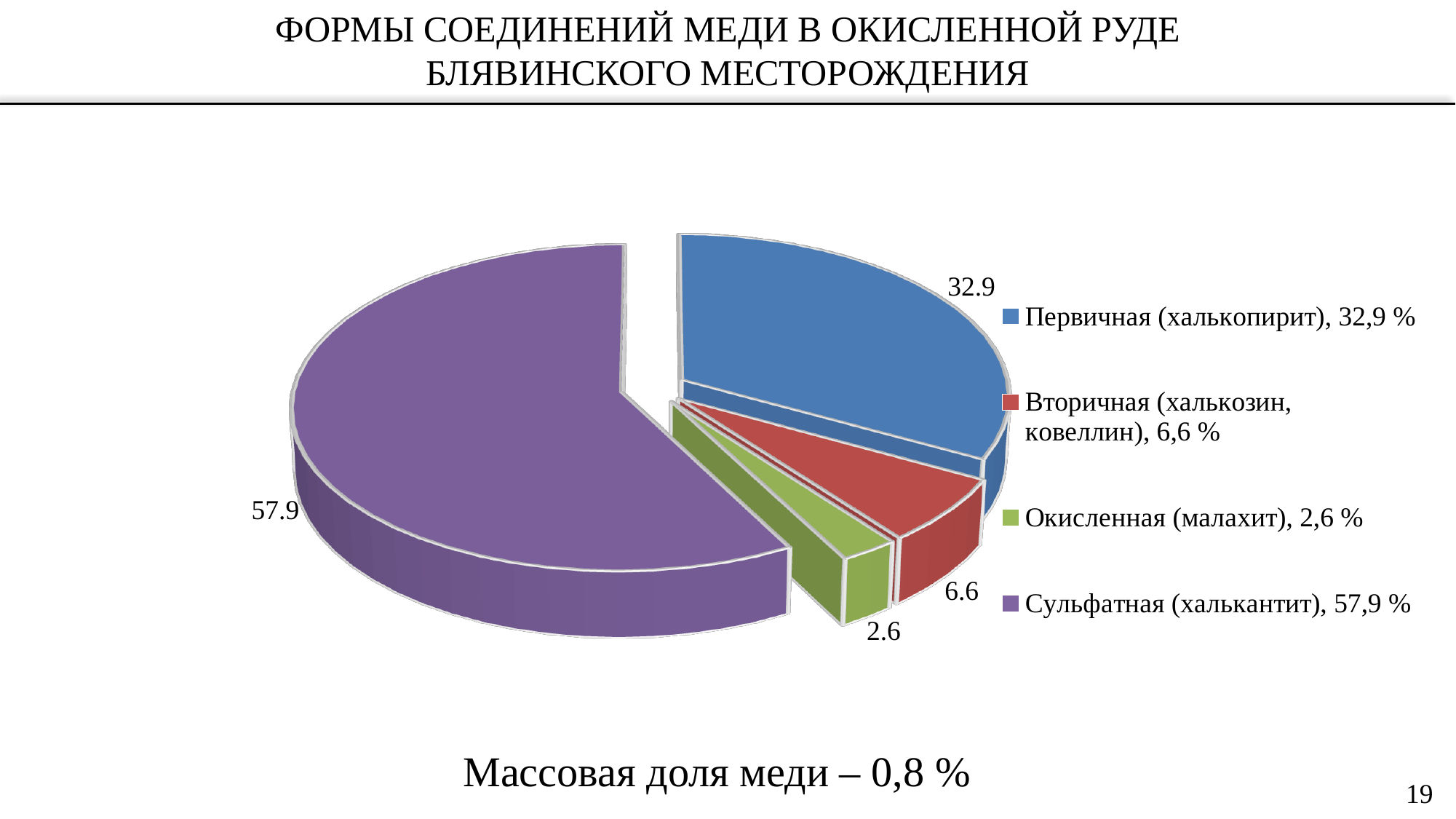
Which category has the smallest slice of the pie? Окисленная (малахит) What is the difference between the values for Сульфатная (халькантит) and Первичная (халькопирит)? 25.0 What is the value shown for Вторичная (халькозин, ковеллин)? 6.6 What percentage does the legend give for Первичная (халькопирит)? 32,9 % What is the value shown for Сульфатная (халькантит)? 57.9 How many slices does the pie chart have? 4 Which category has the largest slice of the pie? Сульфатная (халькантит) Which is larger, the value for Вторичная (халькозин, ковеллин) or the value for Окисленная (малахит)? Вторичная (халькозин, ковеллин) What is the value shown for Первичная (халькопирит)? 32.9 What is the value shown for Окисленная (малахит)? 2.6 What colour is the slice for Сульфатная (халькантит)? Purple What type of chart is shown on the slide? Pie chart